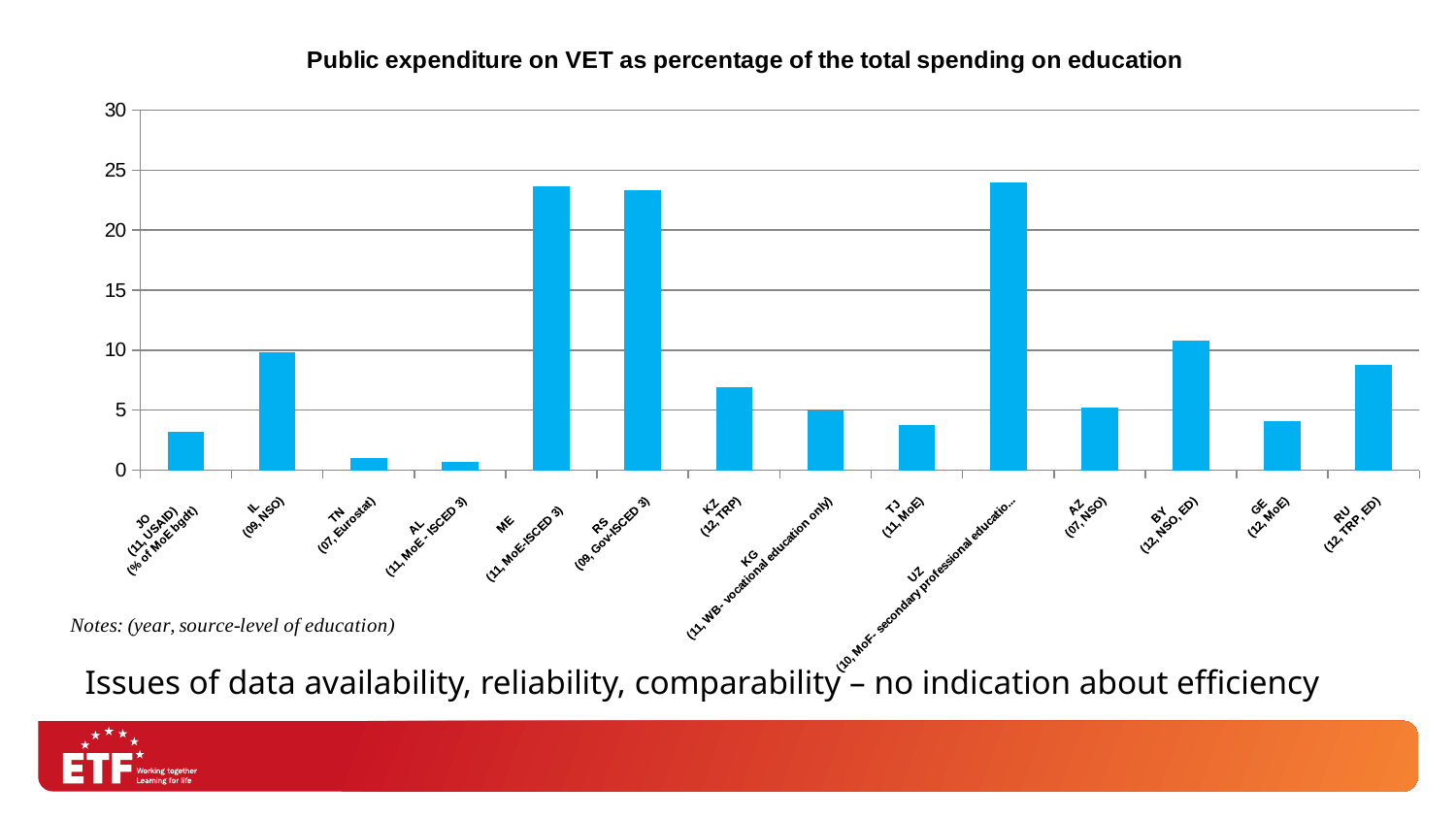
Which has the larger value, BY or RU? BY Is the value for TN greater or less than 5? less Is the value for BY greater or less than 10? greater Which has the larger value, IL or JO? IL Is the value for ME greater or less than 20? greater Which has the larger value, KZ or KG? KZ What kind of chart is shown on the slide? bar chart What is the title of the chart? Public expenditure on VET as percentage of the total spending on education How many countries (categories) are shown on the x axis of the chart? 14